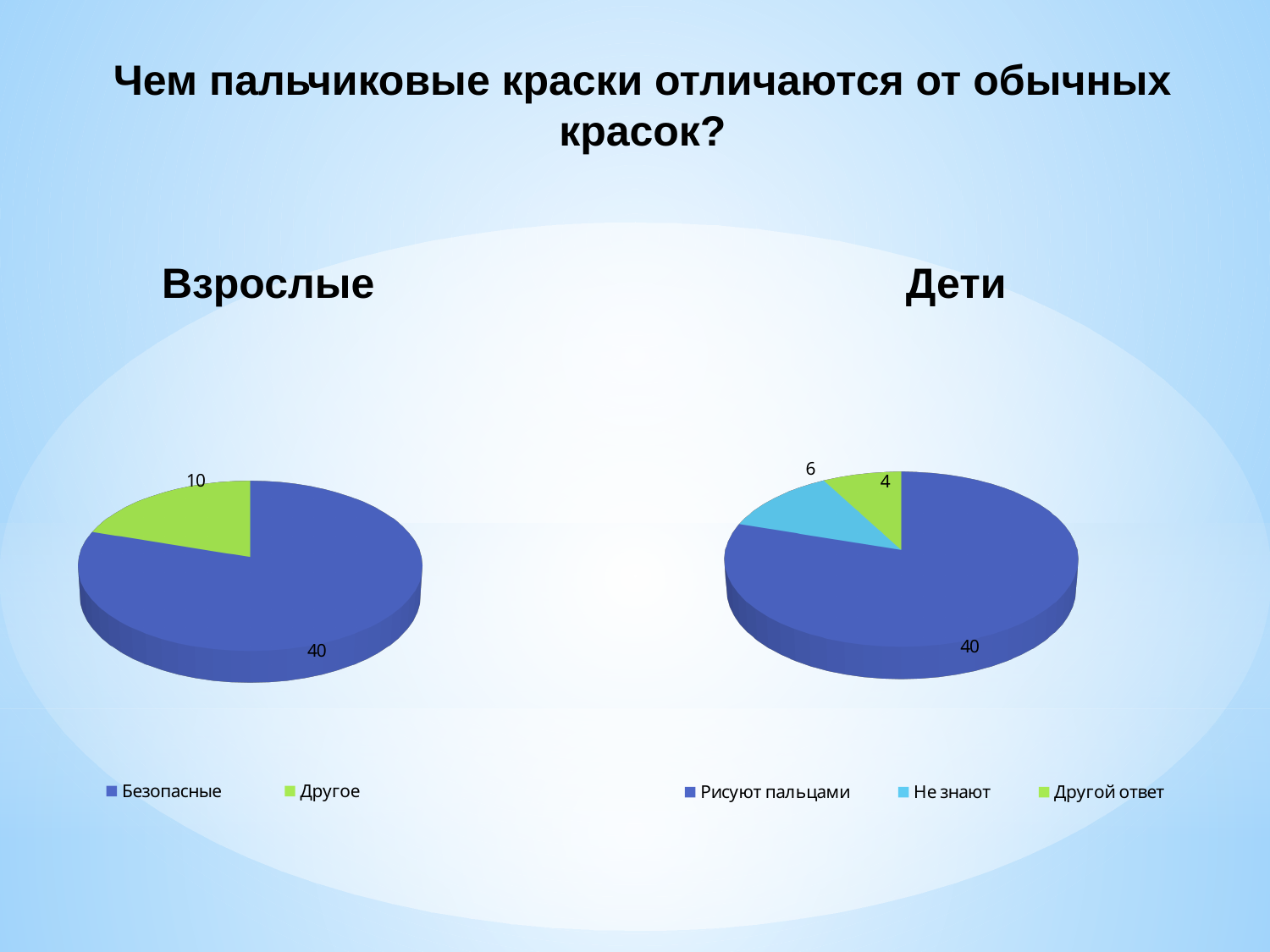
In the "Дети" pie chart, which is larger: "Не знают" or "Другой ответ"? Не знают In the "Взрослые" pie chart, what share of the total does "Другое" represent? 20% How many categories does the "Дети" pie chart have? 3 In the "Взрослые" pie chart, what is the difference between the values for "Безопасные" and "Другое"? 30 In the "Взрослые" pie chart, what is the value for "Другое"? 10 In the "Дети" pie chart, what is the value for "Не знают"? 6 In the "Дети" pie chart, what share of the total does "Рисуют пальцами" represent? 80% In the "Дети" pie chart, which category has the largest slice? Рисуют пальцами In the "Дети" pie chart, what is the value for "Другой ответ"? 4 What type of chart is used under the heading "Взрослые"? Pie chart In the "Дети" pie chart, which category has the smallest slice? Другой ответ In the "Взрослые" pie chart, what is the value for "Безопасные"? 40